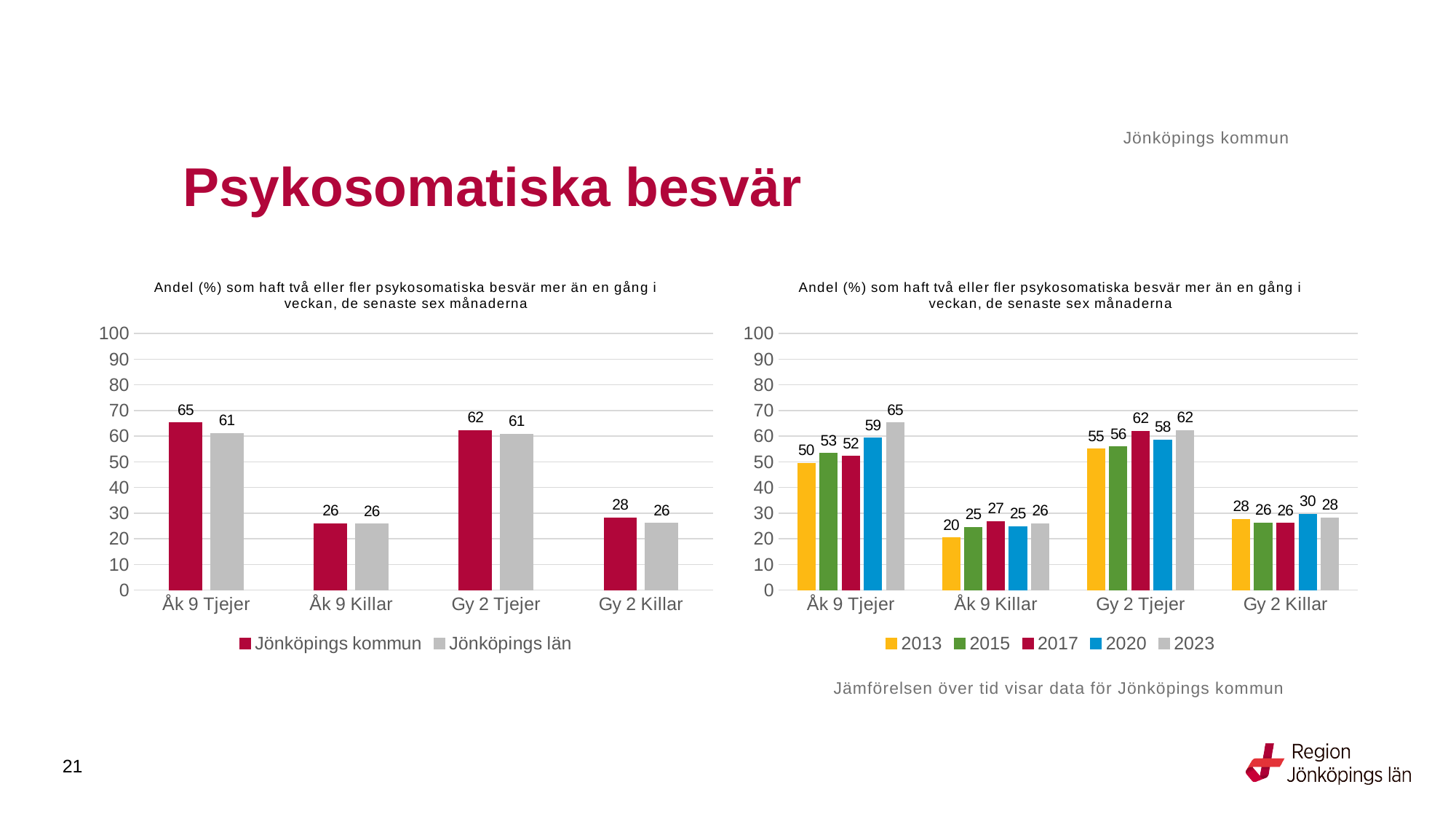
What kind of chart is the left chart? bar chart In the left chart, which category has the lowest value for Jönköpings kommun? Åk 9 Killar In the left chart, what is the value for Jönköpings län for Gy 2 Killar? 26 In the right chart, is the value for 2023 for Gy 2 Killar larger or smaller than the value for 2020 for Gy 2 Killar? smaller In the right chart, which year has the highest value for Åk 9 Tjejer? 2023 In the left chart, how many series does the legend list? 2 In the right chart, what is the value for 2013 for Åk 9 Killar? 20 In the right chart, what is the value for 2020 for Gy 2 Tjejer? 58 In the left chart, what is the difference between Jönköpings kommun and Jönköpings län for Åk 9 Tjejer? 4 In the right chart, how many categories are shown on the x axis? 4 In the right chart, how many series does the legend list? 5 In the left chart, what is the value for Jönköpings kommun for Åk 9 Tjejer? 65